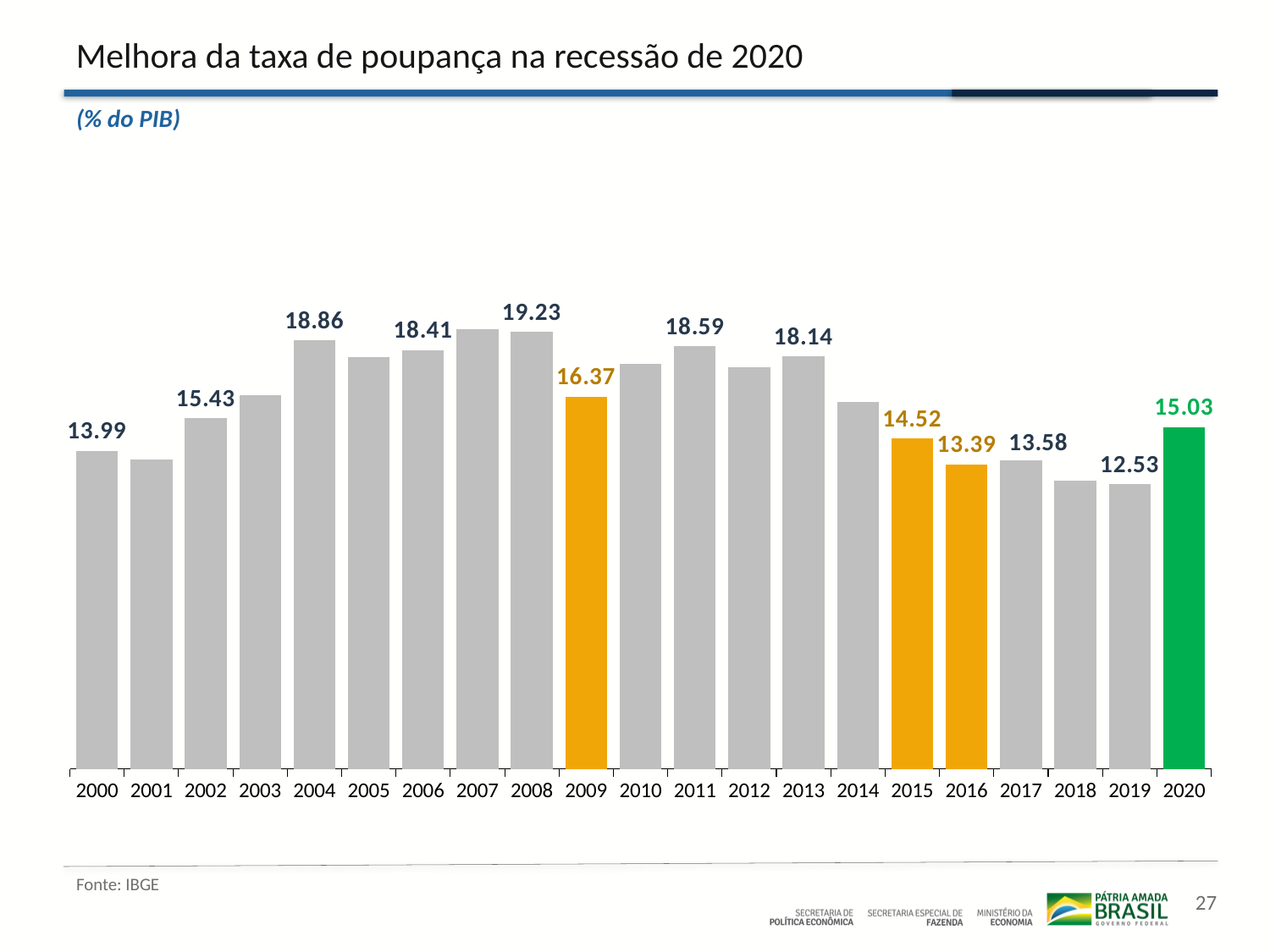
What is the value for 2000? 13.99 What kind of chart is shown on the slide? Bar chart What is the value for 2020? 15.03 What is the value for 2016? 13.39 What is the value for 2008? 19.23 Do the values rise or fall from 2013 to 2019? Fall What is the difference between the values for 2008 and 2000? 5.24 What is the value for 2009? 16.37 Which is larger, the value for 2017 or the value for 2016? 2017 What is the difference between the values for 2020 and 2019? 2.50 How many years are shown on the x axis? 21 Which is larger, the value for 2009 or the value for 2015? 2009